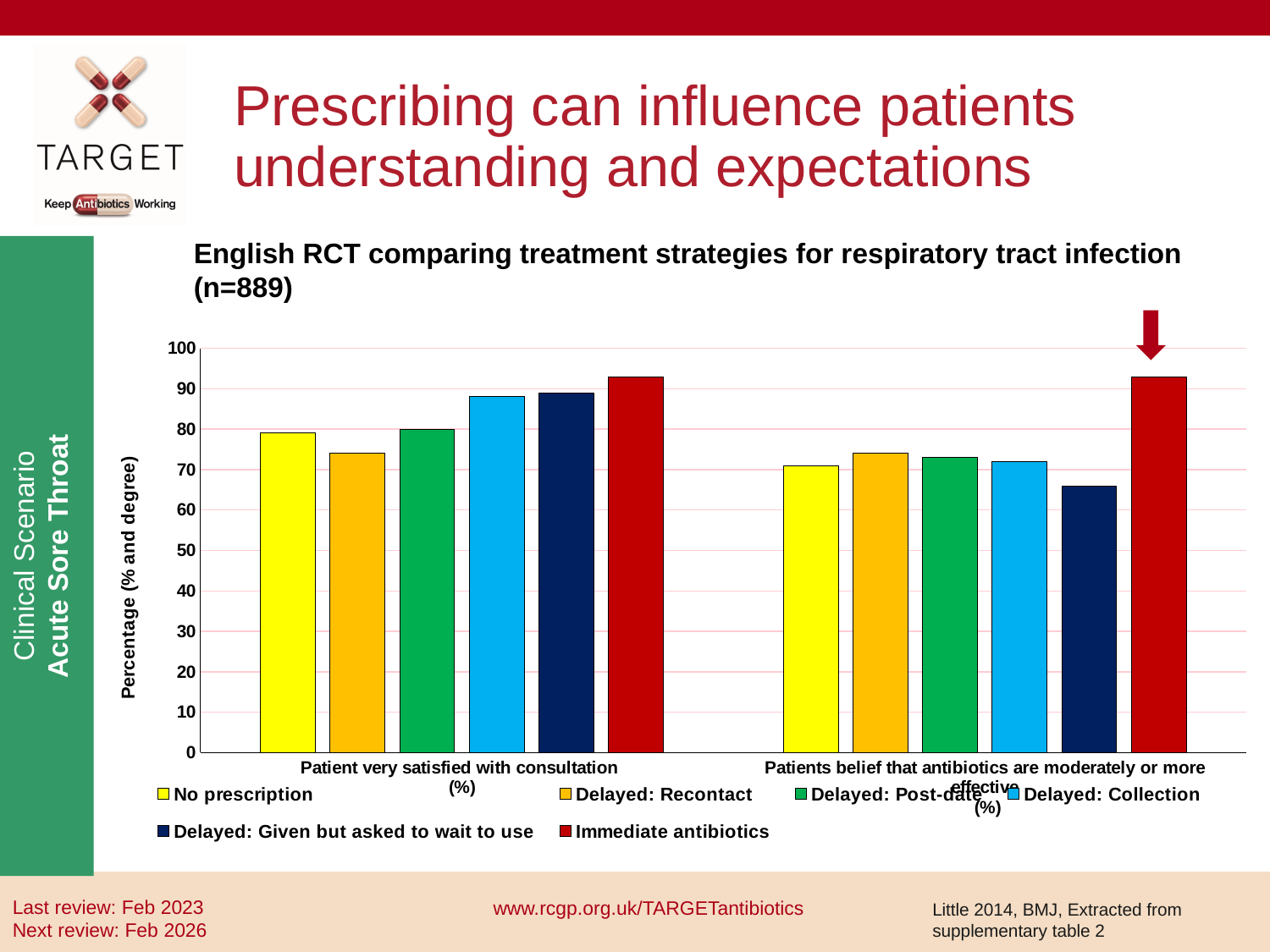
What is the label on the y axis of the chart? Percentage (% and degree) Is the value for Delayed: Collection in 'Patient very satisfied with consultation (%)' greater or less than 80? greater In 'Patients belief that antibiotics are moderately or more effective (%)', which is larger: Immediate antibiotics or No prescription? Immediate antibiotics Is the value for Immediate antibiotics in 'Patient very satisfied with consultation (%)' greater or less than 90? greater What kind of chart is shown on the slide? Bar chart How many categories are shown on the x axis? 2 Which treatment strategy has the lowest value for 'Patient very satisfied with consultation (%)'? Delayed: Recontact Is the value for Delayed: Given but asked to wait to use in 'Patients belief that antibiotics are moderately or more effective (%)' greater or less than 70? less How many series does the legend list? 6 Which treatment strategy has the highest value for 'Patient very satisfied with consultation (%)'? Immediate antibiotics Which treatment strategy has the lowest value for 'Patients belief that antibiotics are moderately or more effective (%)'? Delayed: Given but asked to wait to use Which treatment strategy has the highest value for 'Patients belief that antibiotics are moderately or more effective (%)'? Immediate antibiotics